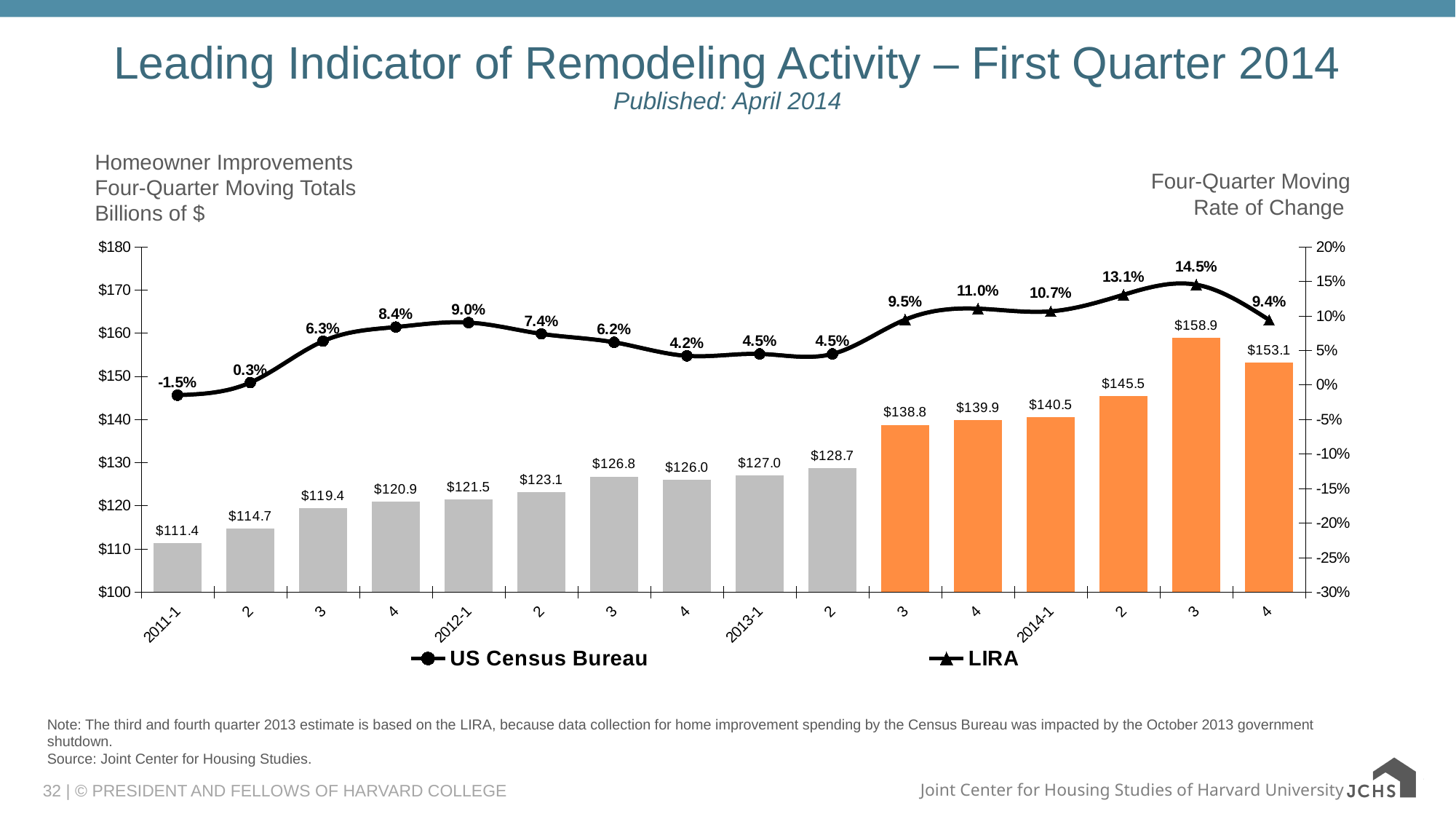
How many series does the legend list? 2 Which quarter has the highest four-quarter moving total bar? 2014-3 What is the rate of change shown for the fourth quarter of 2014 (2014-4)? 9.4% What is the four-quarter moving rate of change shown for 2012-1? 9.0% Do the four-quarter moving total bars rise or fall from 2013-2 to 2014-3? Rise Which has the larger four-quarter moving total, 2012-3 or 2012-4? 2012-3 What is the four-quarter moving total for the third quarter of 2014 (2014-3)? $158.9 How many quarters are plotted along the x axis? 16 What is the difference between the four-quarter moving totals for 2014-3 and 2014-4? $5.8 What are the two series named in the legend? US Census Bureau and LIRA Which quarter has the lowest four-quarter moving rate of change? 2011-1 What kind of chart is shown on the slide? Combined bar and line chart